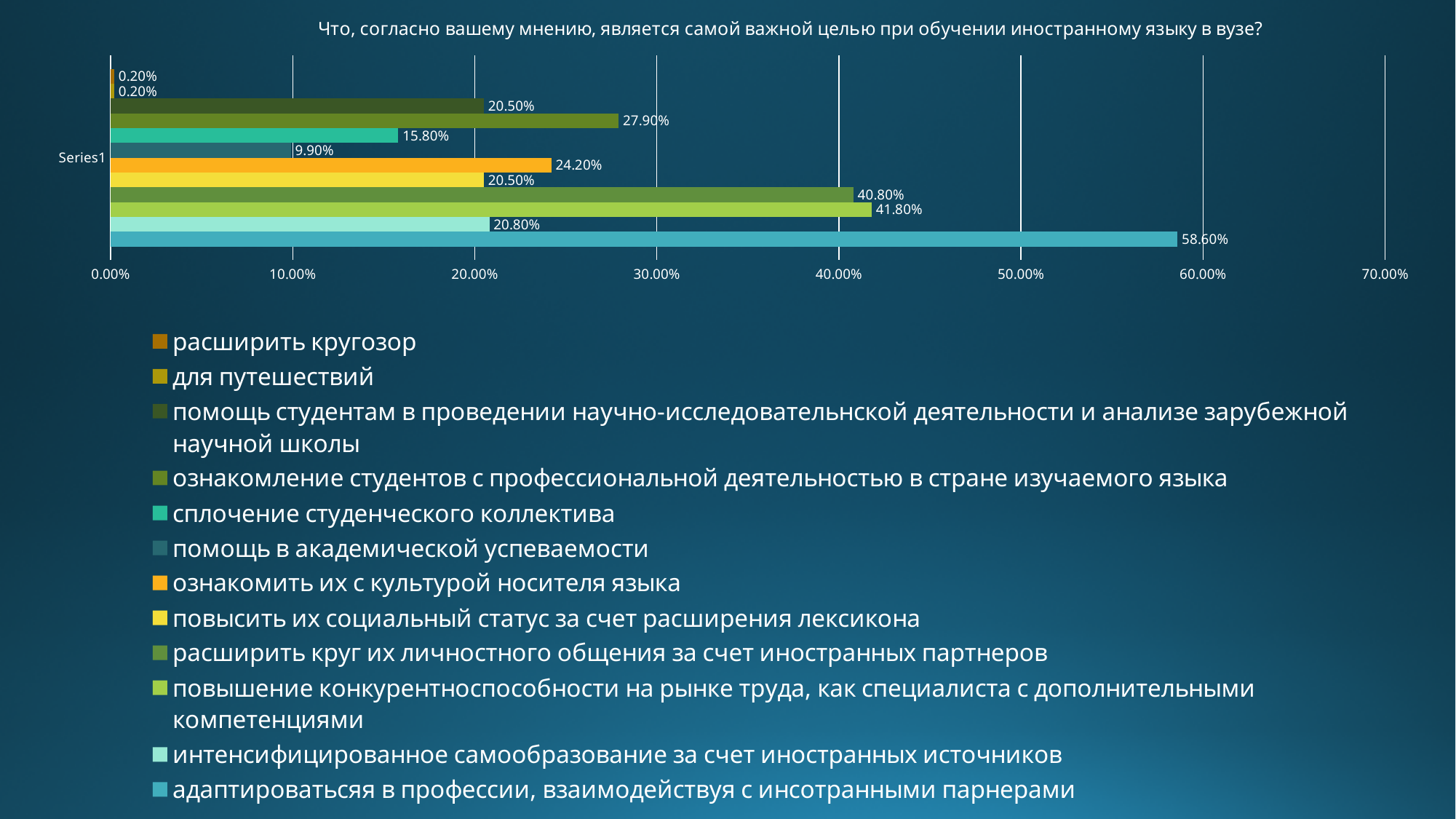
What is the value for 'сплочение студенческого коллектива'? 15.80% What is the value for 'расширить кругозор'? 0.20% What is the value for 'адаптироватьсяя в профессии, взаимодействуя с иностранными парнерами'? 58.60% What type of chart is shown on the slide? bar chart How many series does the legend list? 12 What is the title of the chart? Что, согласно вашему мнению, является самой важной целью при обучении иностранному языку в вузе? What is the value for 'ознакомить их с культурой носителя языка'? 24.20% What is the value for 'помощь в академической успеваемости'? 9.90% Is the value for 'расширить круг их личностного общения за счет иностранных партнеров' greater or less than 30.00%? greater Which is larger: the value for 'ознакомление студентов с профессиональной деятельностью в стране изучаемого языка' or the value for 'ознакомить их с культурой носителя языка'? ознакомление студентов с профессиональной деятельностью в стране изучаемого языка What is the difference between the values for 'адаптироватьсяя в профессии, взаимодействуя с иностранными парнерами' and 'повышение конкурентноспособности на рынке труда, как специалиста с дополнительными компетенциями'? 16.80% Which legend entry has the highest value? адаптироватьсяя в профессии, взаимодействуя с иностранными парнерами